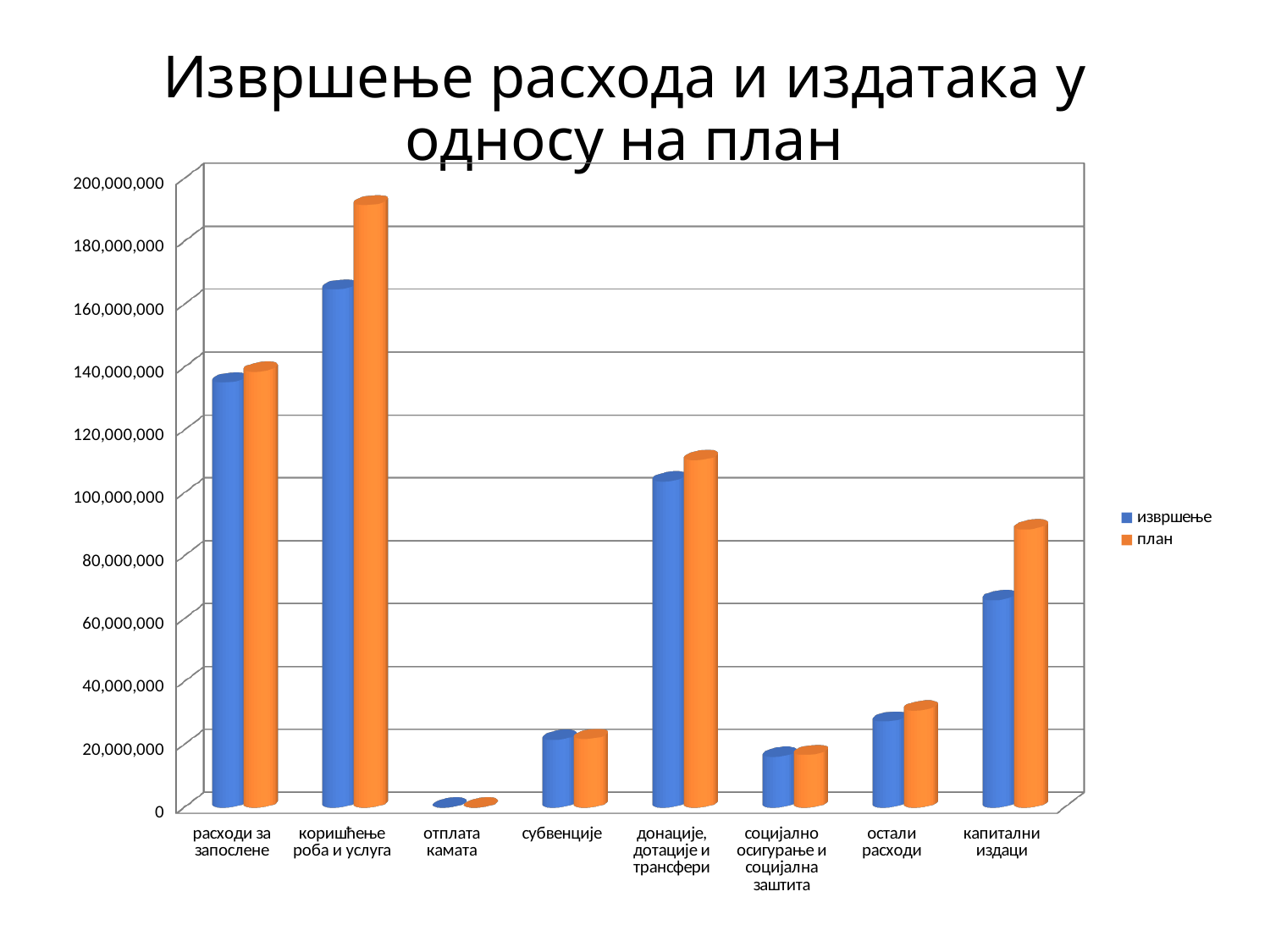
For капитални издаци, which is larger: извршење or план? план What is the title of the chart on the slide? Извршење расхода и издатака у односу на план How many series does the legend list? 2 Is the план value for коришћење роба и услуга greater or less than 180,000,000? greater For расходи за запослене, which is larger: извршење or план? план Is the план value for капитални издаци greater or less than 80,000,000? greater What kind of chart is shown on the slide? bar chart How many categories are shown on the x axis of the chart? 8 Which category has the lowest извршење value? отплата камата Which category has the highest план value? коришћење роба и услуга Is the извршење value for социјално осигурање и социјална заштита greater or less than 20,000,000? less